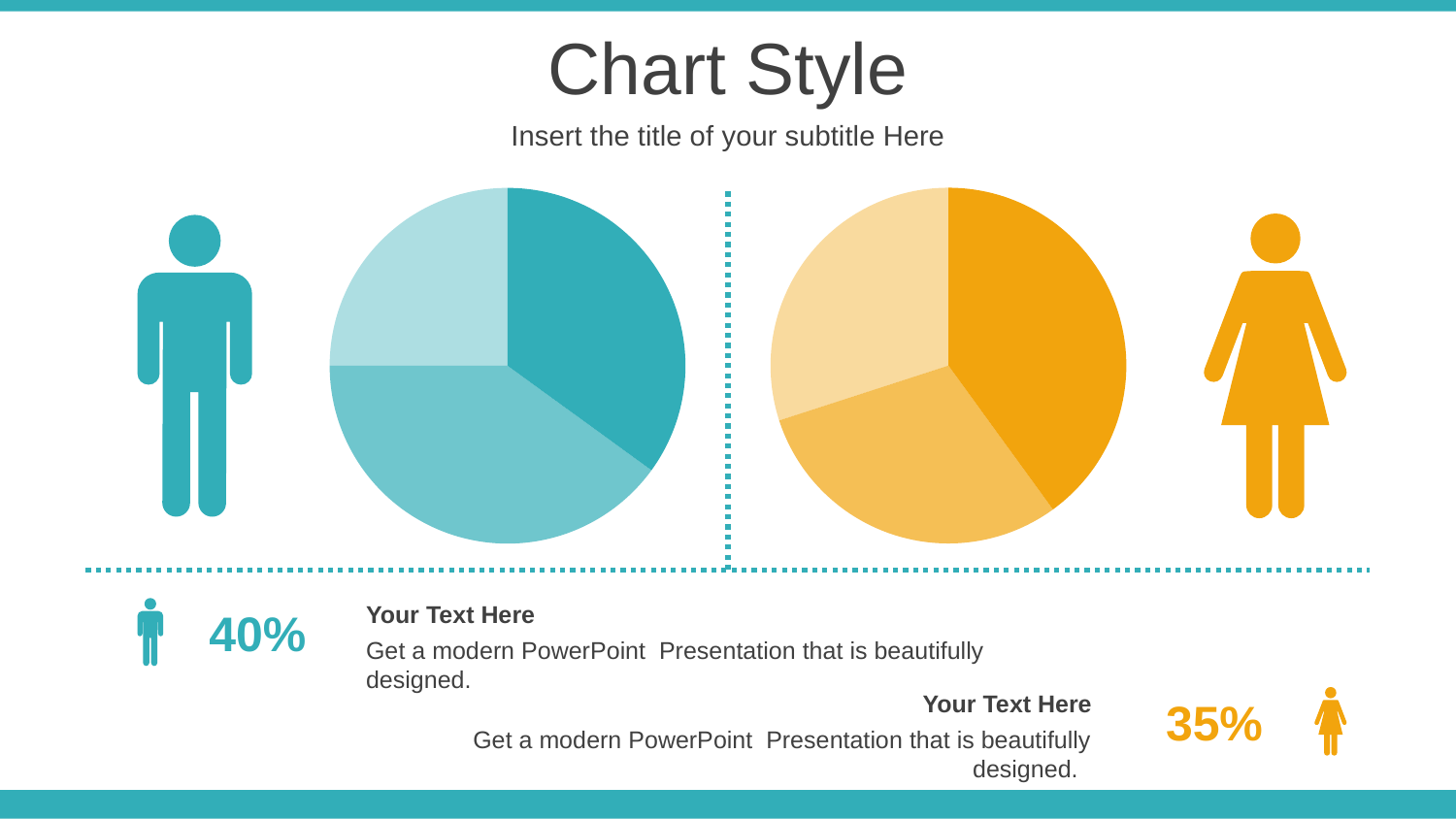
In the right pie chart (next to the female figure), how many slices are there? 3 What kind of chart is shown on the left side of the slide, next to the male figure? pie chart What colour scheme is used for the left pie chart (next to the male figure)? shades of teal In the left pie chart (next to the male figure), which slice is the smallest? the lightest teal slice In the left pie chart (next to the male figure), how many slices are there? 3 What colour scheme is used for the right pie chart (next to the female figure)? shades of orange In the right pie chart (next to the female figure), which slice is the largest? the darkest orange slice What kind of chart is shown on the right side of the slide, next to the female figure? pie chart How many charts are on the slide? 2